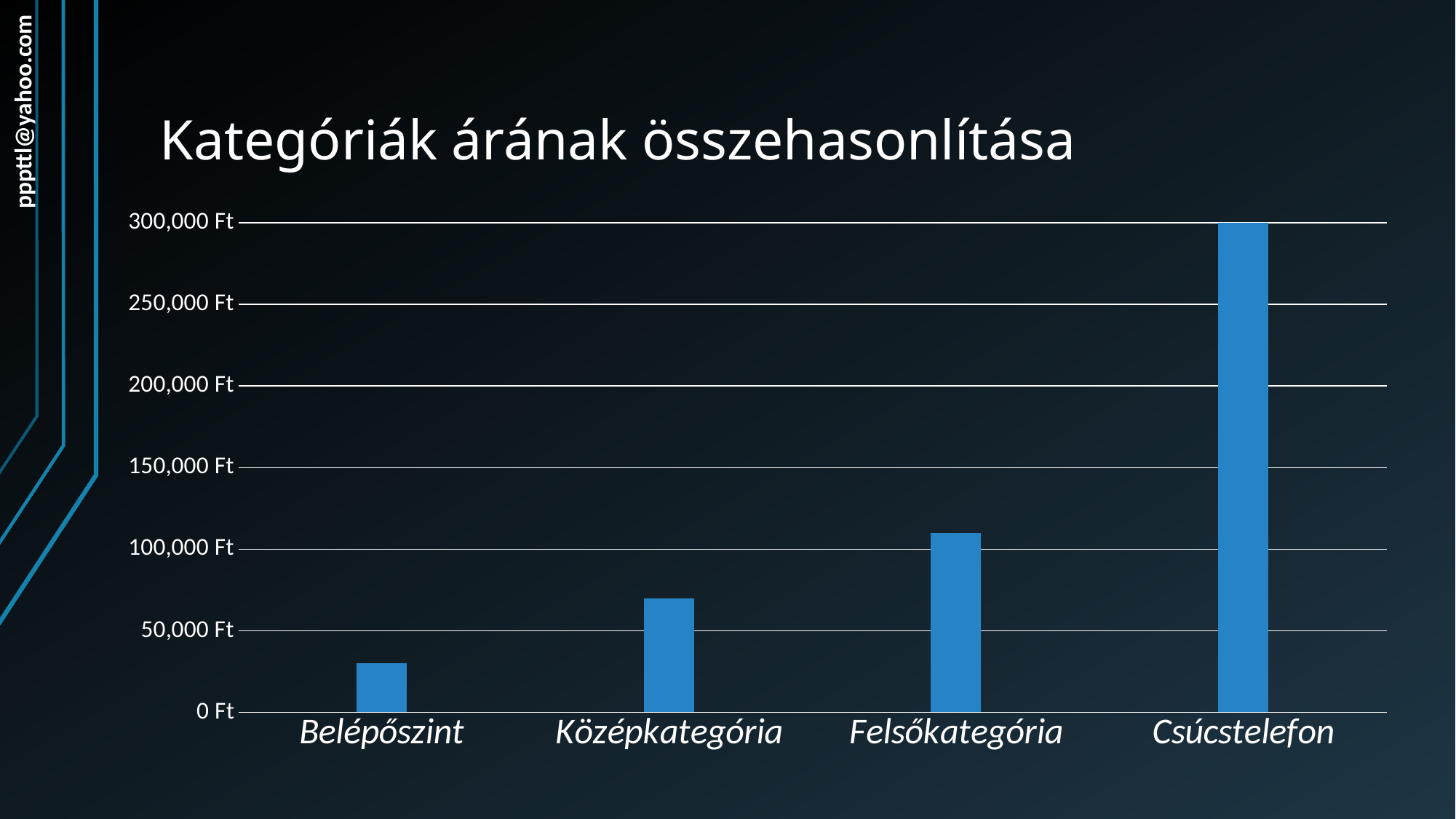
Which is larger, the value for Középkategória or the value for Felsőkategória? Felsőkategória Is the value for Felsőkategória greater or less than 150,000 Ft? less Which category has the highest value? Csúcstelefon What is the title of the chart? Kategóriák árának összehasonlítása What is the value for Csúcstelefon? 300,000 Ft Is the value for Csúcstelefon greater or less than 250,000 Ft? greater Is the value for Belépőszint greater or less than 50,000 Ft? less Do the values rise or fall from Belépőszint to Csúcstelefon along the x axis? rise Which category has the lowest value? Belépőszint How many categories are shown on the x axis? 4 What kind of chart is shown on the slide? bar chart